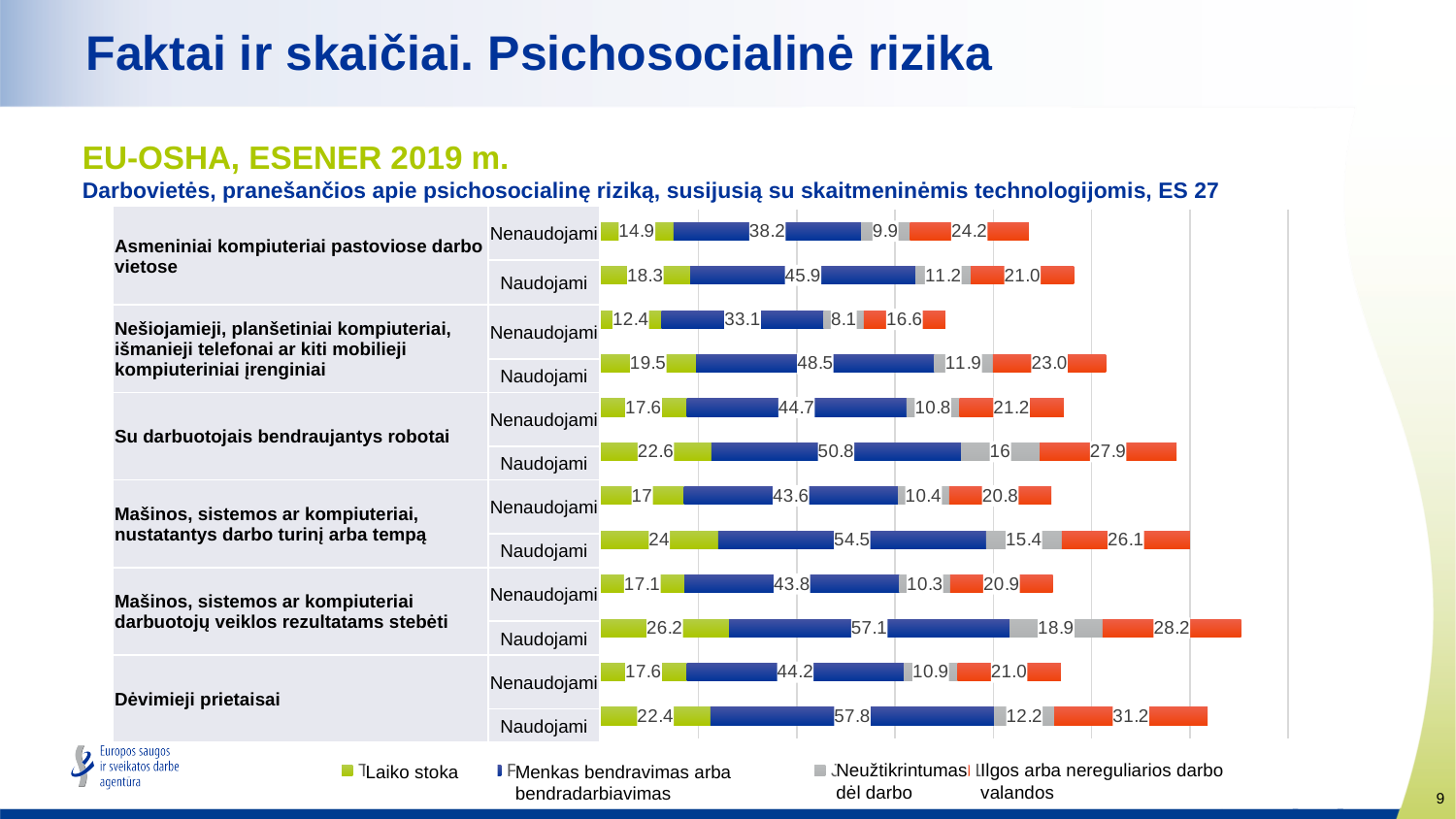
How many stacked bars are plotted in the chart? 12 What is the difference in Laiko stoka between Naudojami and Nenaudojami under 'Mašinos, sistemos ar kompiuteriai, nustatantys darbo turinį arba tempą'? 7 Which bar has the highest value for Menkas bendravimas arba bendradarbiavimas? Naudojami, Dėvimieji prietaisai (57.8) What is the value of Ilgos arba nereguliarios darbo valandos for Naudojami under 'Su darbuotojais bendraujantys robotai'? 27.9 What type of chart is shown on the slide? Stacked bar chart What is the value of Laiko stoka for Naudojami under 'Dėvimieji prietaisai'? 22.4 What is the value of Menkas bendravimas arba bendradarbiavimas for Nenaudojami under 'Asmeniniai kompiuteriai pastoviose darbo vietose'? 38.2 How many series does the legend list? 4 What is the total of the stacked bar for Naudojami under 'Nešiojamieji, planšetiniai kompiuteriai, išmanieji telefonai ar kiti mobilieji kompiuteriniai įrenginiai'? 102.9 What is the value of Neužtikrintumas dėl darbo for Naudojami under 'Mašinos, sistemos ar kompiuteriai darbuotojų veiklos rezultatams stebėti'? 18.9 Which is larger: Ilgos arba nereguliarios darbo valandos for Naudojami or Nenaudojami under 'Asmeniniai kompiuteriai pastoviose darbo vietose'? Nenaudojami (24.2) Which bar has the lowest value for Laiko stoka? Nenaudojami, Nešiojamieji, planšetiniai kompiuteriai, išmanieji telefonai ar kiti mobilieji kompiuteriniai įrenginiai (12.4)